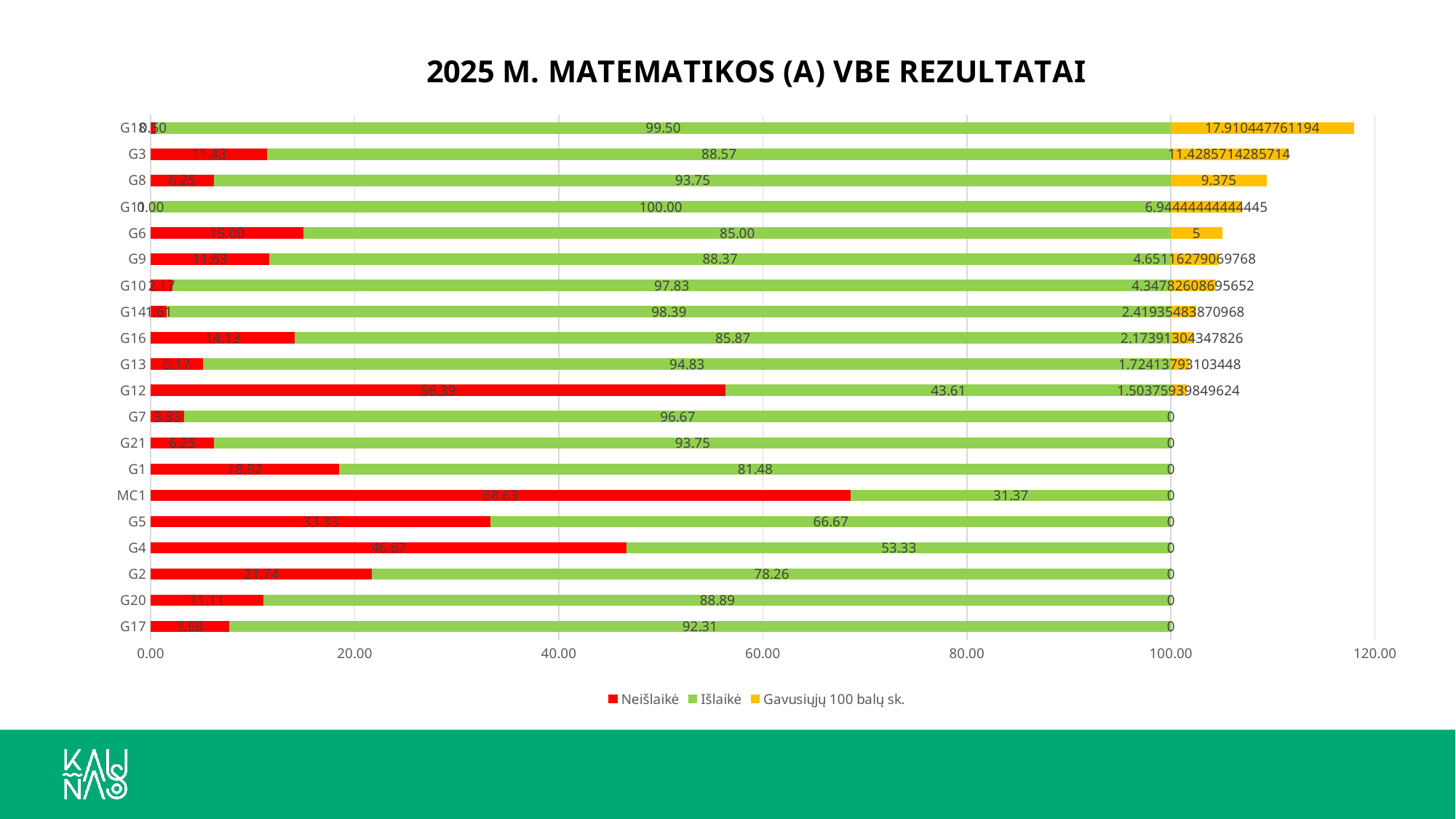
Which category has the lowest Išlaikė value? MC1 How many series does the legend list? 3 What is the Gavusiųjų 100 balų sk. value for G8? 9.375 Which category has the highest Neišlaikė value? MC1 Which has the larger Neišlaikė value, G4 or G5? G4 What is the Išlaikė value for G12? 43.61 Which category has the highest Gavusiųjų 100 balų sk. value? G18 How many categories are shown on the chart? 20 Is the Neišlaikė value for G12 greater or less than 40? greater What is the Gavusiųjų 100 balų sk. value for G6? 5 What is the Neišlaikė value for MC1? 68.63 What is the difference between the Išlaikė and Neišlaikė values for G5? 33.34